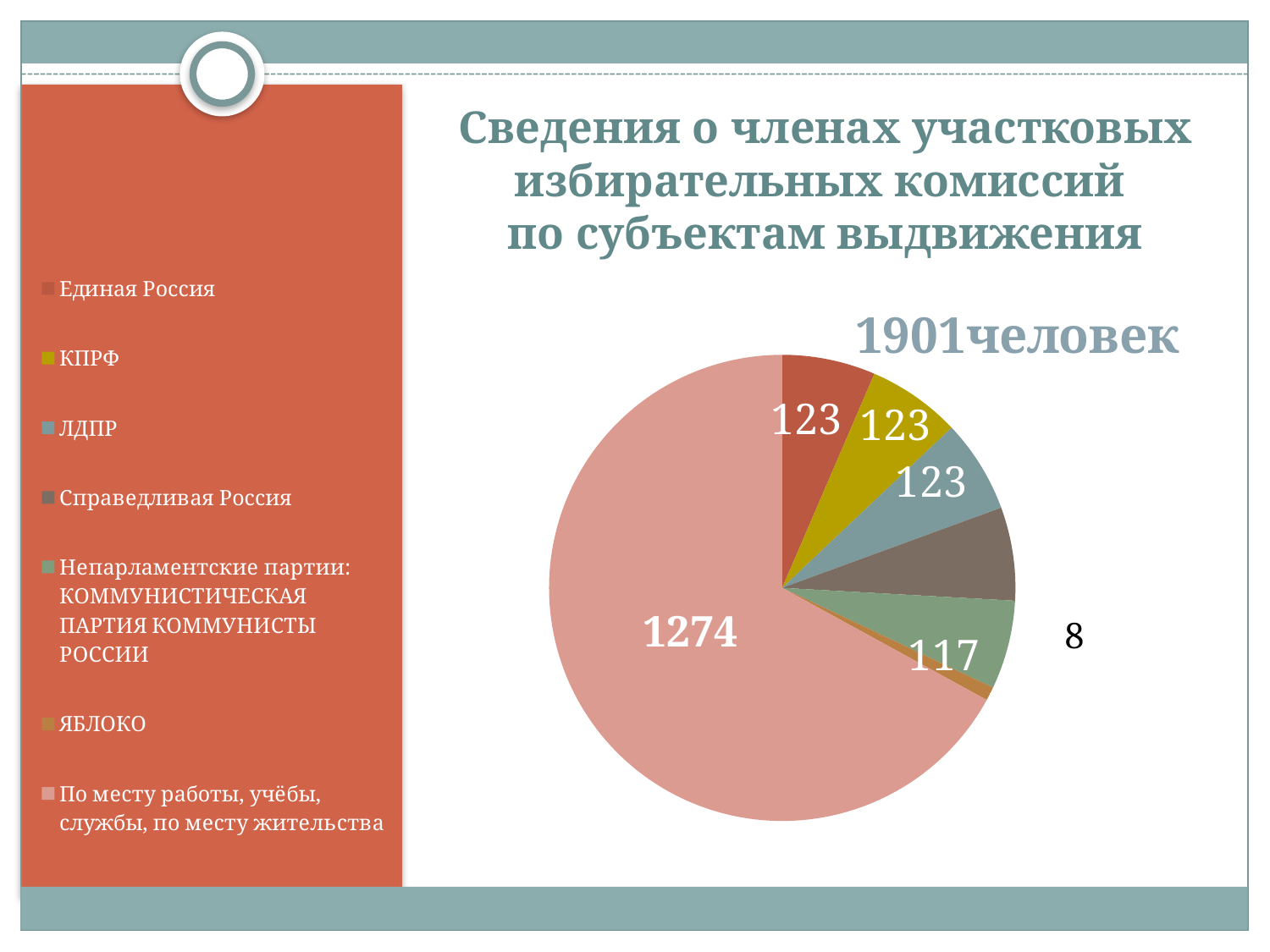
Which category has the smallest slice of the pie? ЯБЛОКО How many categories does the legend list? 7 What is the difference between the value for По месту работы, учёбы, службы, по месту жительства and the value for Непарламентские партии? 1157 What is the value for Непарламентские партии: КОММУНИСТИЧЕСКАЯ ПАРТИЯ КОММУНИСТЫ РОССИИ? 117 Which is larger, the value for По месту работы, учёбы, службы, по месту жительства or the value for ЛДПР? По месту работы, учёбы, службы, по месту жительства What is the value for ЛДПР? 123 What total number of people is stated above the pie chart? 1901человек What is the value for Единая Россия? 123 What kind of chart is shown on the slide? pie chart Which category has the largest slice of the pie? По месту работы, учёбы, службы, по месту жительства What is the value for По месту работы, учёбы, службы, по месту жительства? 1274 What is the value for КПРФ? 123